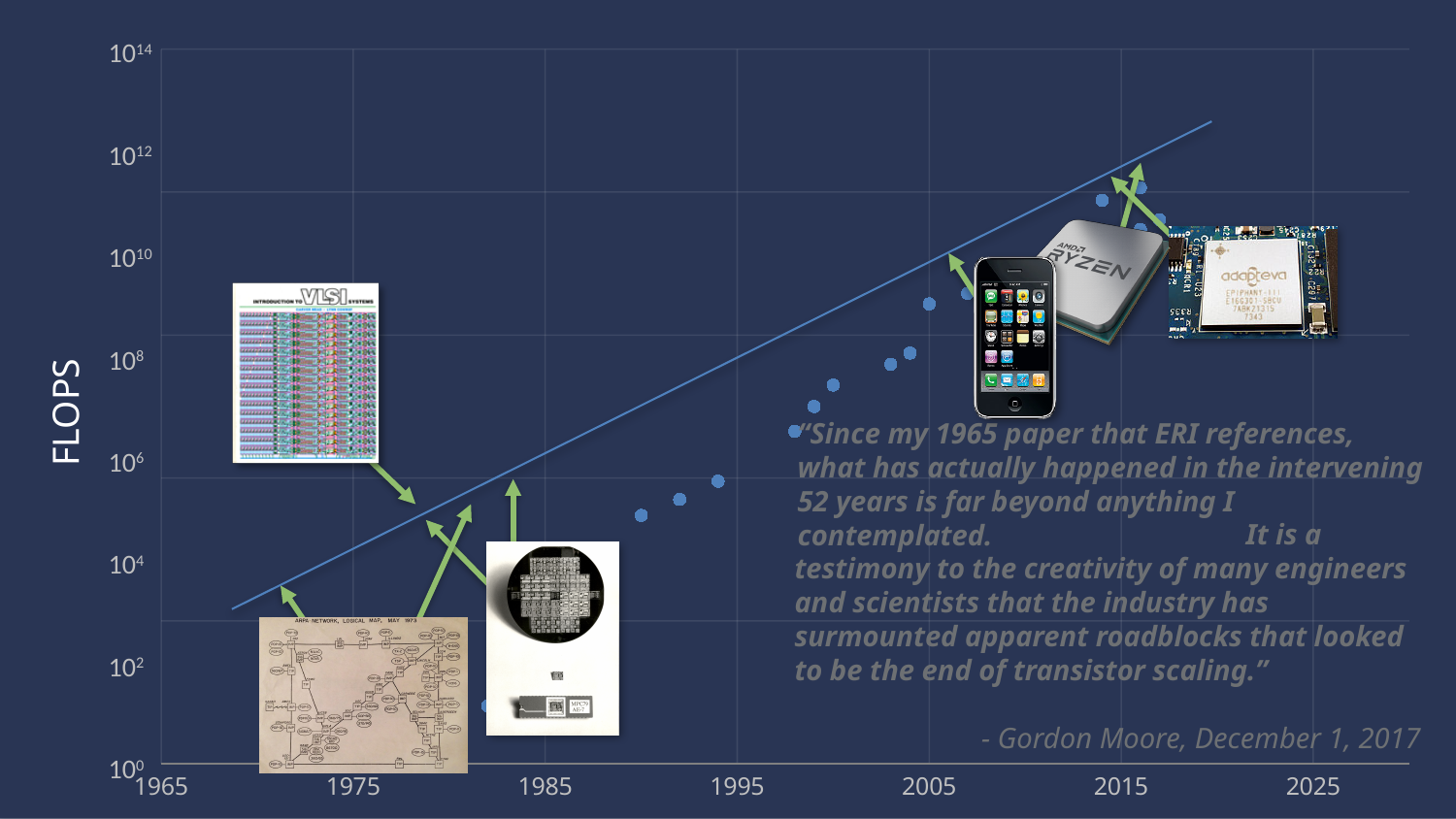
What kind of chart is shown on the slide? scatter chart What is the lowest tick value shown on the vertical axis? 10^0 Are the FLOPS values of the points plotted around 2015 greater or less than 10^10? greater Do the plotted FLOPS values rise or fall as the year increases along the x axis? rise What is the label on the vertical axis of the chart? FLOPS Is the FLOPS value of the point plotted around 1990 greater or less than 10^4? greater What is the last year shown on the horizontal axis? 2025 Is the FLOPS value of the point plotted around 1990 greater or less than 10^6? less What is the highest tick value shown on the vertical axis? 10^14 What is the first year shown on the horizontal axis? 1965 Does the straight trend line on the chart slope upward or downward from left to right? upward